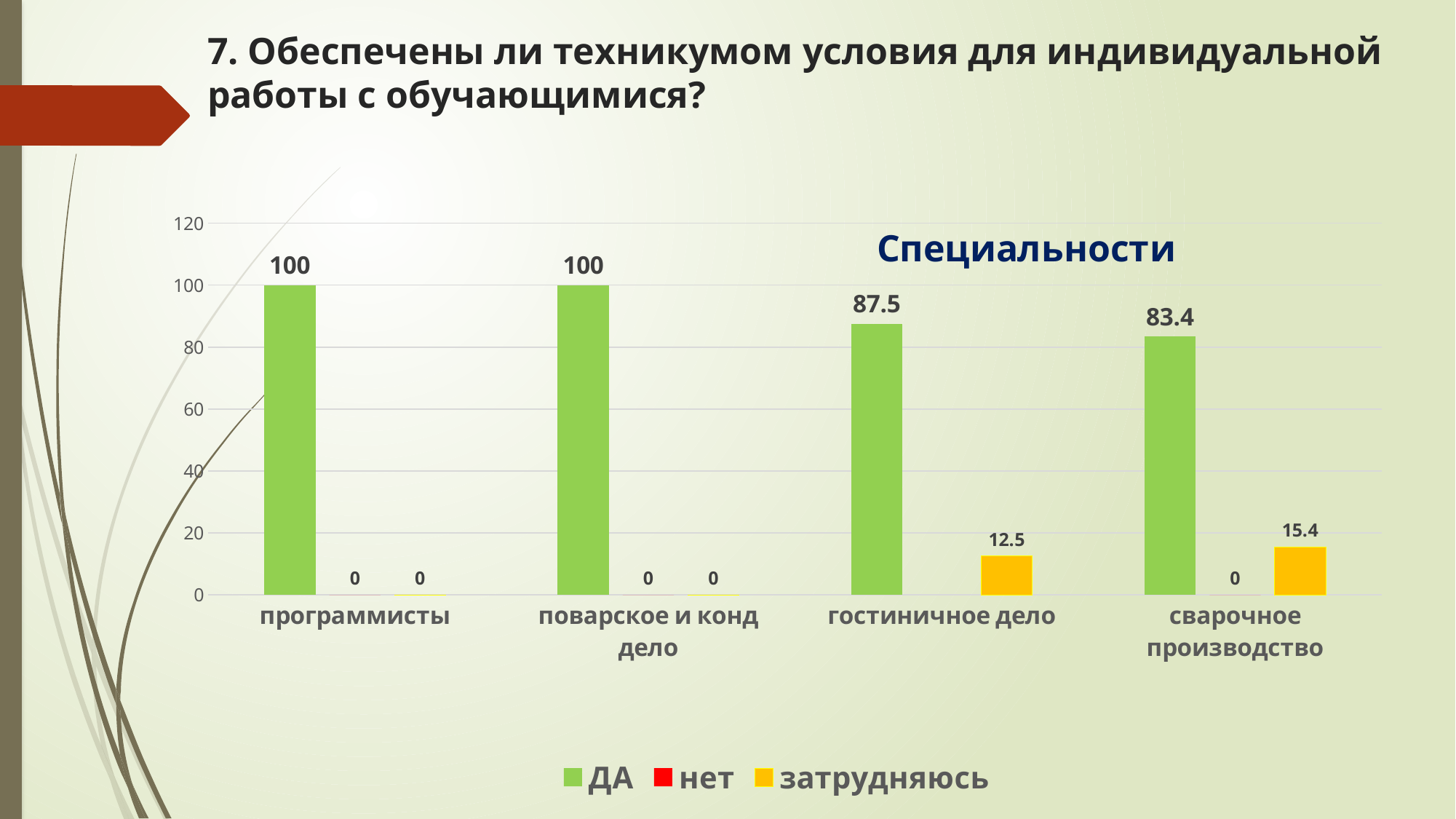
How many series does the legend list? 3 What is the value of затрудняюсь for сварочное производство? 15.4 Which category has the lowest value for ДА? сварочное производство What type of chart is shown on the slide? bar chart What is the difference between the ДА values for гостиничное дело and сварочное производство? 4.1 What colour represents the series ДА in the legend? green How many categories are shown on the x axis? 4 Which is larger: затрудняюсь for гостиничное дело or затрудняюсь for сварочное производство? сварочное производство What is the value of ДА for гостиничное дело? 87.5 What is the value of ДА for сварочное производство? 83.4 What is the value of ДА for программисты? 100 What is the value of затрудняюсь for гостиничное дело? 12.5